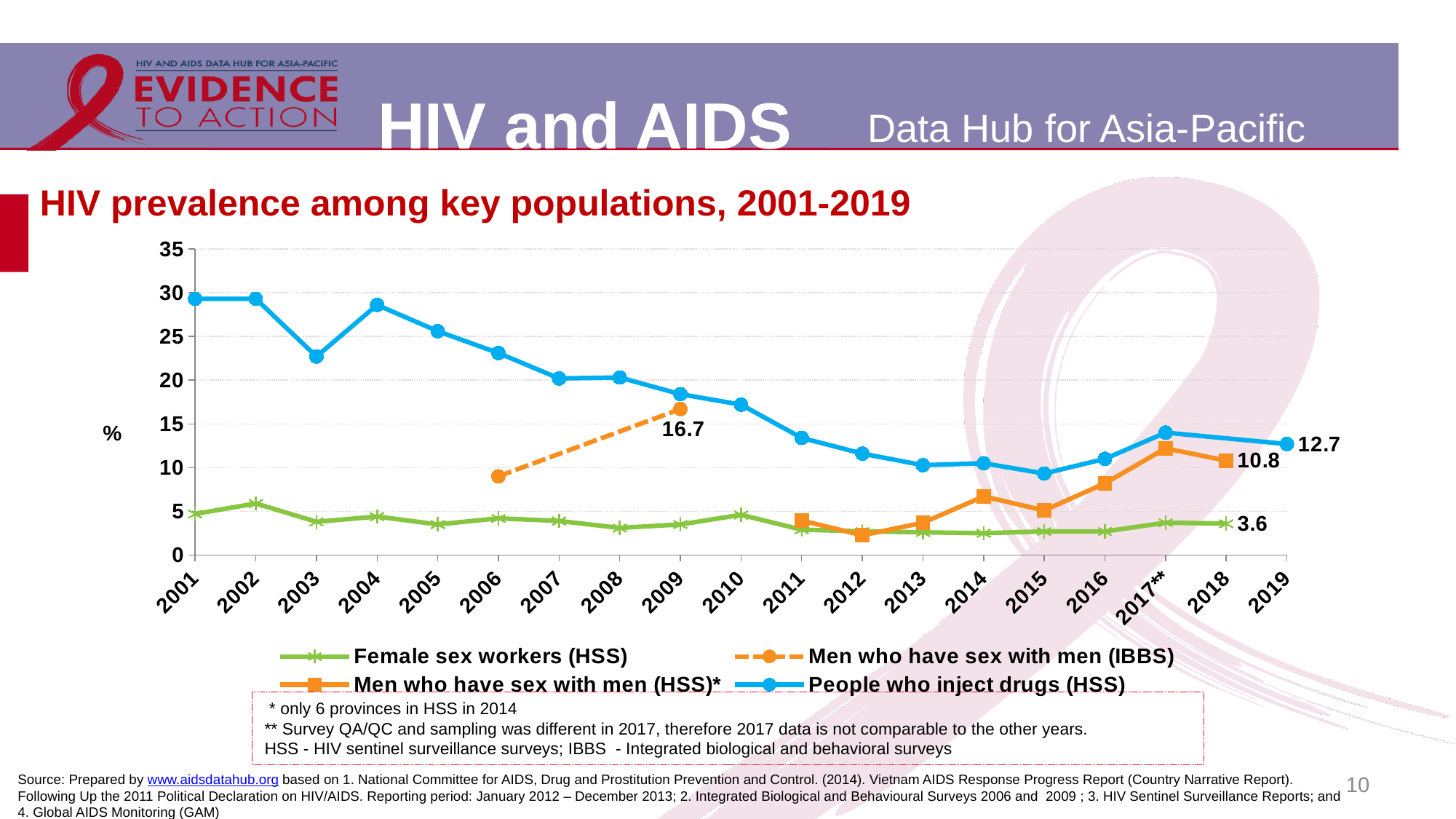
What is the HIV prevalence among men who have sex with men (IBBS) in 2009? 16.7 Does the value for people who inject drugs (HSS) rise or fall from 2004 to 2015? Fall What is the HIV prevalence among people who inject drugs (HSS) in 2019? 12.7 Is the value for female sex workers (HSS) in 2012 greater or less than 5? less Is the value for people who inject drugs (HSS) in 2001 greater or less than 25? greater How many series does the legend list? 4 How many years are shown on the x axis? 19 What kind of chart is shown on the slide? Line chart What is the HIV prevalence among men who have sex with men (HSS) in 2018? 10.8